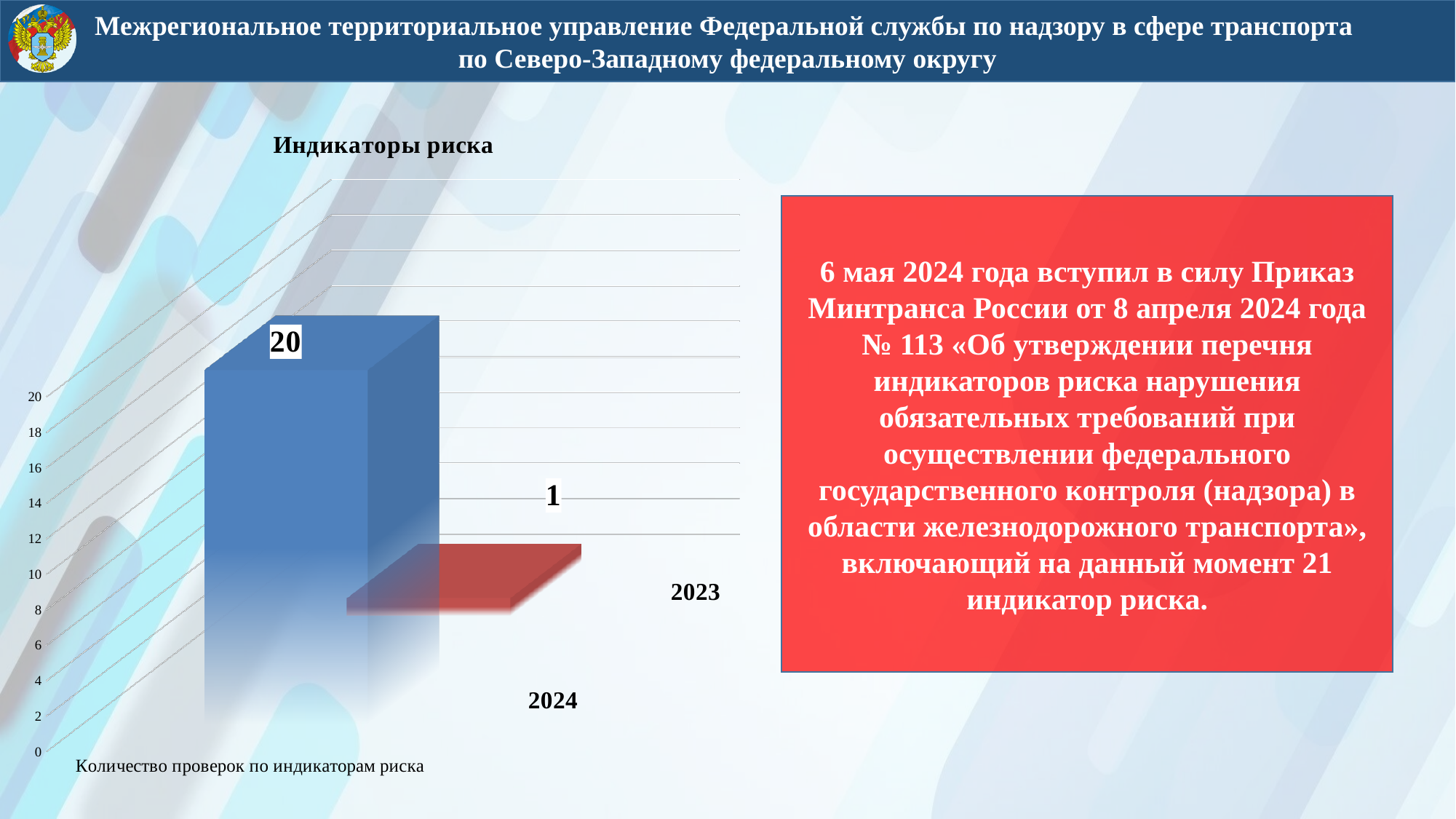
What is the title of the chart on the slide? Индикаторы риска How many categories (years) are shown in the 'Индикаторы риска' chart? 2 Do the values in the 'Индикаторы риска' chart rise or fall from 2023 to 2024? rise What is the value for 2024 in the 'Индикаторы риска' chart? 20 Which year has the lowest value in the 'Индикаторы риска' chart? 2023 What colour is the bar for 2024 in the 'Индикаторы риска' chart? blue Which year has the highest value in the 'Индикаторы риска' chart? 2024 What is the difference between the values for 2024 and 2023 in the 'Индикаторы риска' chart? 19 Which is larger in the 'Индикаторы риска' chart: the value for 2023 or the value for 2024? 2024 What is the value for 2023 in the 'Индикаторы риска' chart? 1 Is the value for 2024 in the 'Индикаторы риска' chart greater or less than 10? greater What kind of chart is 'Индикаторы риска'? bar chart